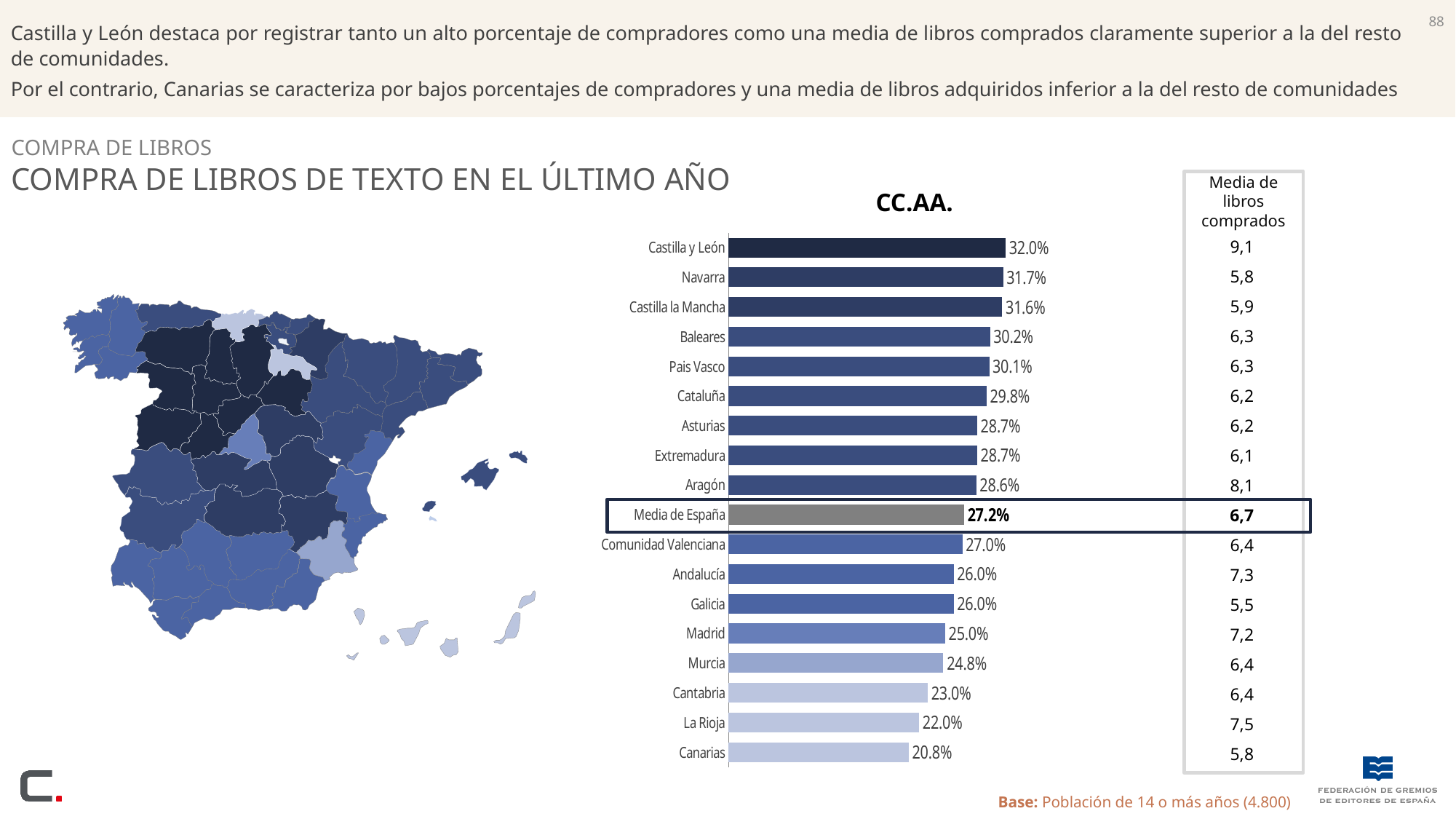
How many bars are shown in the CC.AA. bar chart, including Media de España? 18 What is the value for Castilla y León in the CC.AA. bar chart? 32.0% What is the value for Media de España in the CC.AA. bar chart? 27.2% What is the difference between the values for Navarra and Media de España in the CC.AA. bar chart? 4.5% What is the difference between the values for Castilla y León and Canarias in the CC.AA. bar chart? 11.2% What kind of chart is the CC.AA. chart? Bar chart Which category has the lowest value in the CC.AA. bar chart? Canarias What is the value for Canarias in the CC.AA. bar chart? 20.8% Which has a larger value in the CC.AA. bar chart, Baleares or Cantabria? Baleares What is the value for Madrid in the CC.AA. bar chart? 25.0% Which category has the highest value in the CC.AA. bar chart? Castilla y León Do the values in the CC.AA. bar chart rise or fall from the top bar to the bottom bar? Fall